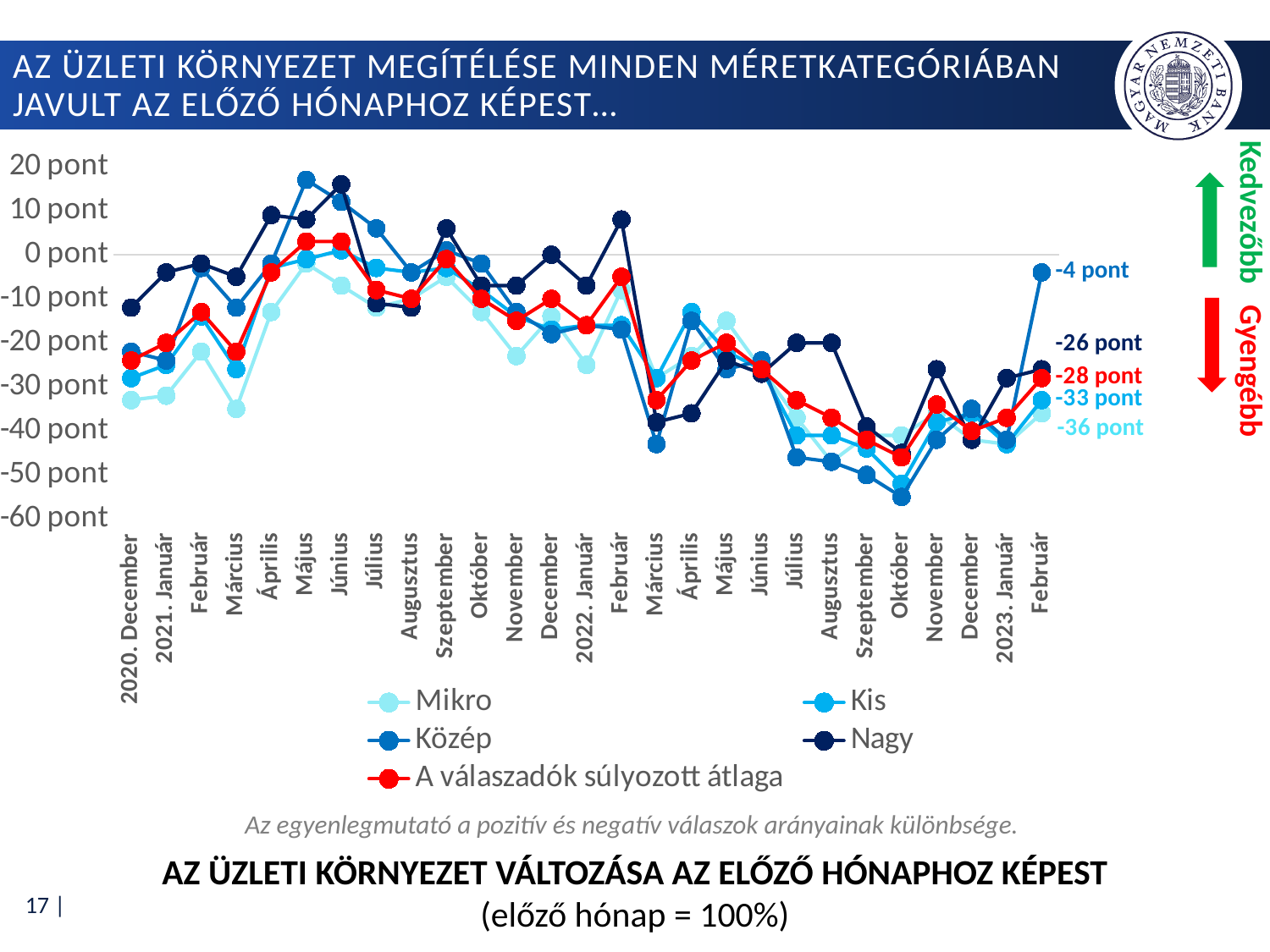
What is the value for Mikro in Február 2023? -36 pont Which series has the lowest value in Február 2023? Mikro What is the value for Közép in Február 2023? -4 pont What is the value for A válaszadók súlyozott átlaga in Február 2023? -28 pont Which series has the highest value in Február 2023? Közép What kind of chart is shown on the slide? line chart How many series does the legend list? 5 What is the value for Nagy in Február 2023? -26 pont Is the value for Közép in Május 2021 greater or less than 10 pont? greater In Február 2023, which is larger: the value for Kis or the value for Nagy? Nagy How many months are shown on the x axis? 27 What is the difference between the Közép and Mikro values in Február 2023? 32 pont